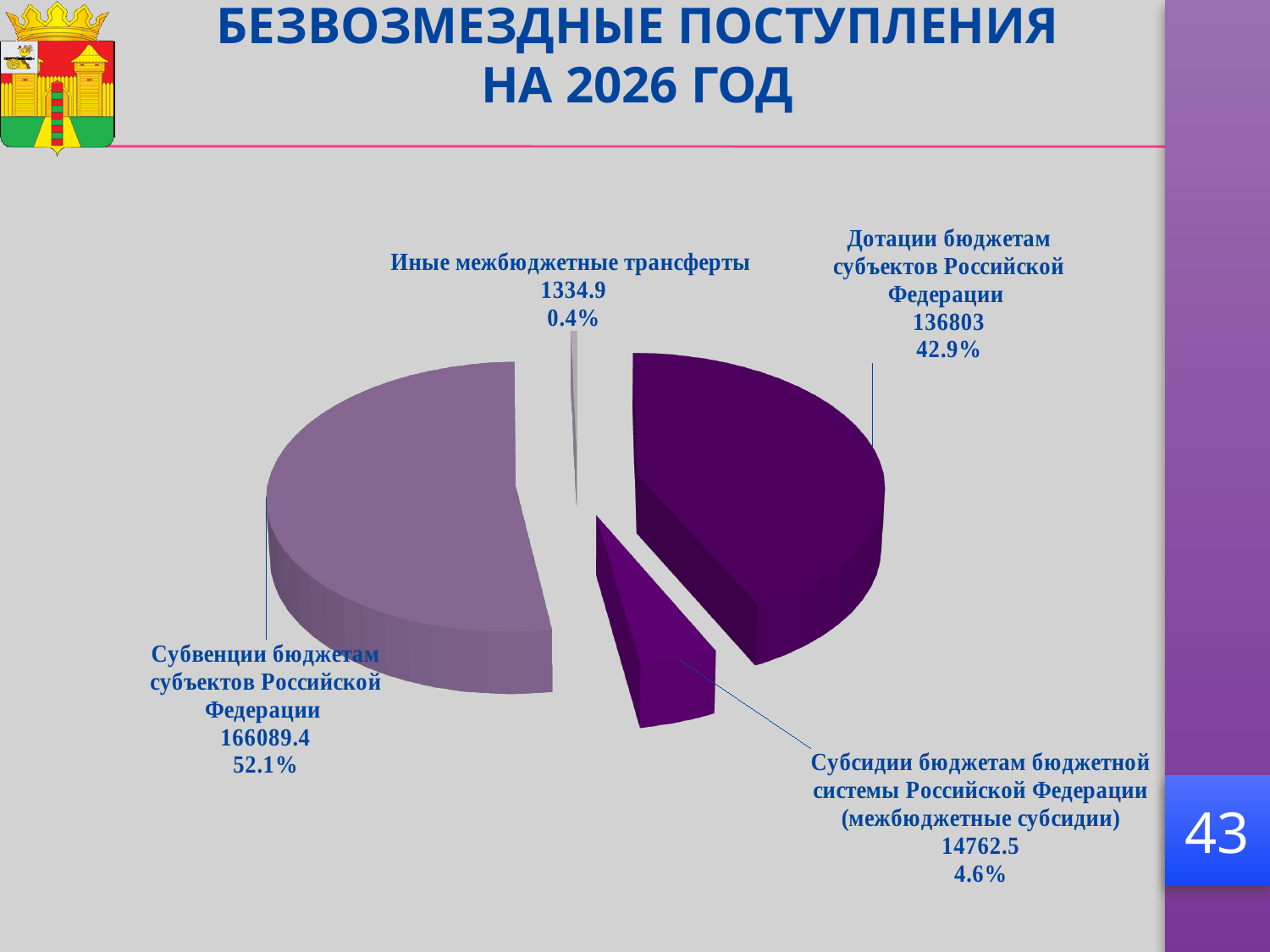
What kind of chart is shown on the slide? Pie chart Which category has the largest slice? Субвенции бюджетам субъектов Российской Федерации Which category has the smallest slice? Иные межбюджетные трансферты What share of the pie does Иные межбюджетные трансферты represent? 0.4% What is the value for Субсидии бюджетам бюджетной системы Российской Федерации (межбюджетные субсидии)? 14762.5 How many slices does the pie chart have? 4 What is the value for Дотации бюджетам субъектов Российской Федерации? 136803 What share of the pie does Дотации бюджетам субъектов Российской Федерации represent? 42.9% What is the difference between the values for Субвенции бюджетам субъектов Российской Федерации and Дотации бюджетам субъектов Российской Федерации? 29286.4 What is the value for Субвенции бюджетам субъектов Российской Федерации? 166089.4 What is the title of the slide containing the chart? БЕЗВОЗМЕЗДНЫЕ ПОСТУПЛЕНИЯ НА 2026 ГОД What is the value for Иные межбюджетные трансферты? 1334.9